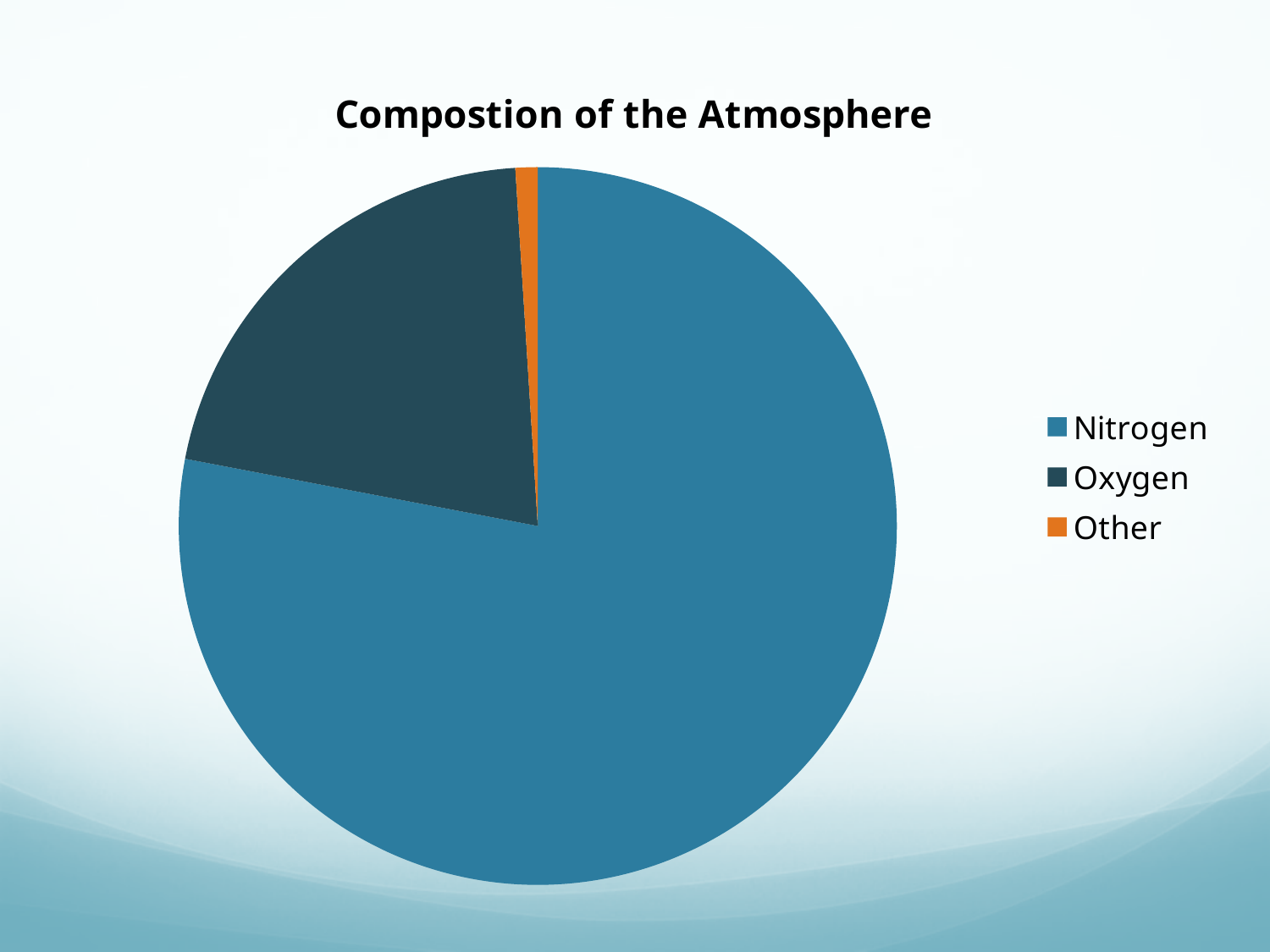
How many entries does the legend list? 3 What kind of chart is shown on the slide? pie chart Which category is shown in orange? Other Which slice is larger, Oxygen or Other? Oxygen How many slices does the pie chart have? 3 Which category has the largest slice of the pie? Nitrogen What is the title of the chart? Compostion of the Atmosphere Which category has the smallest slice of the pie? Other Which slice is larger, Nitrogen or Oxygen? Nitrogen Does the Nitrogen slice take up more or less than half of the pie? more